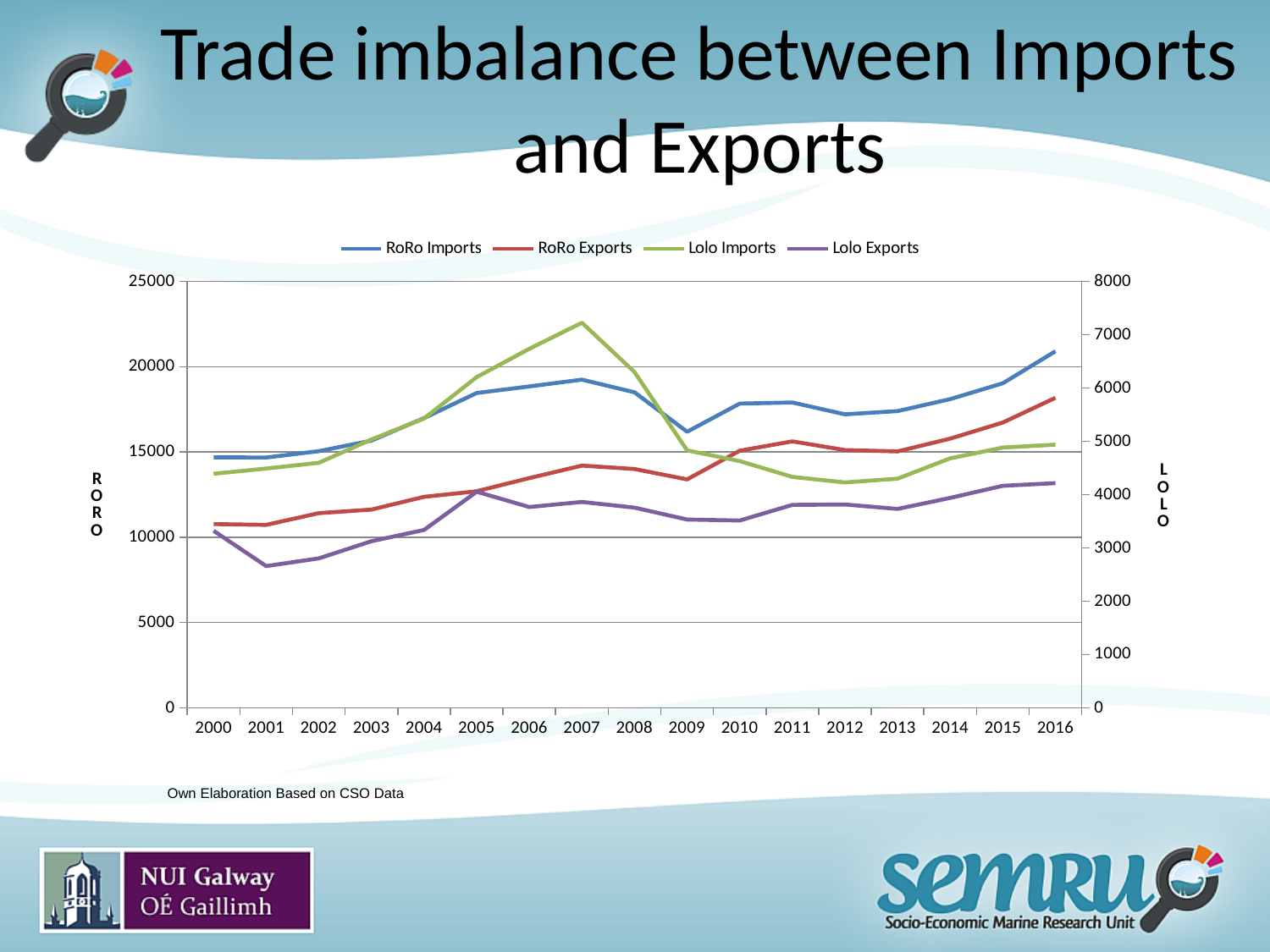
Is the value for Lolo Imports in 2007 greater or less than 6000 on the LOLO axis? greater Is the value for RoRo Exports in 2000 greater or less than 15000 on the RORO axis? less Is the value for Lolo Exports in 2001 greater or less than 3000 on the LOLO axis? less Which colour is used for the RoRo Imports line? blue How many series does the legend list? 4 Does the Lolo Imports line rise or fall between 2007 and 2009? fall In which year does the Lolo Imports line reach its highest point? 2007 Which is larger, RoRo Imports in 2009 or RoRo Imports in 2010? 2010 What kind of chart is shown on the slide? line chart How many years are plotted along the x axis? 17 In which year does the Lolo Exports line reach its lowest point? 2001